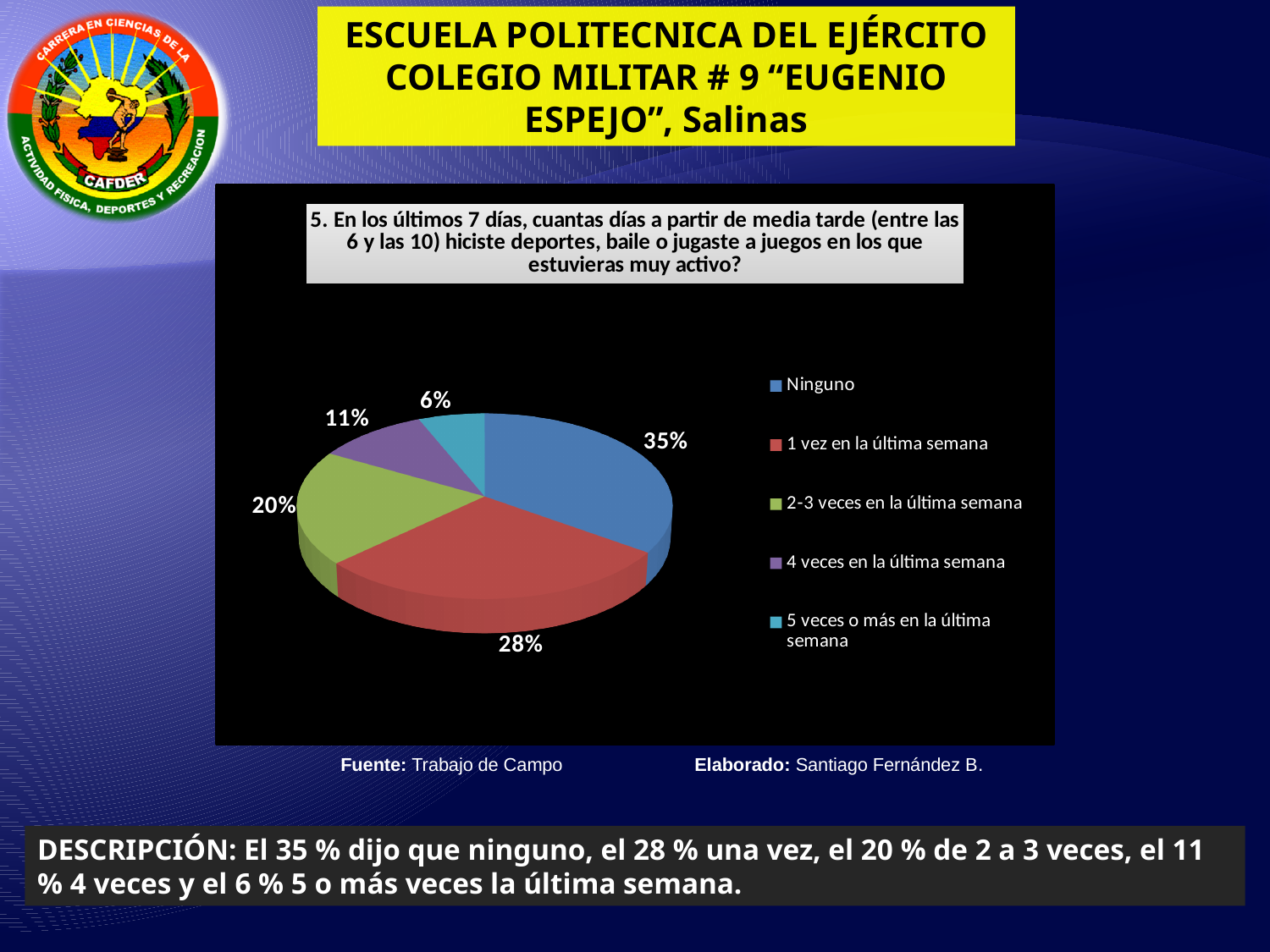
What percentage of respondents answered "4 veces en la última semana"? 11% What percentage of respondents answered "2-3 veces en la última semana"? 20% What percentage of respondents answered "1 vez en la última semana"? 28% Which is larger: the share for "2-3 veces en la última semana" or "4 veces en la última semana"? 2-3 veces en la última semana What colour is the slice for "Ninguno"? Blue How many categories does the legend list? 5 What percentage of respondents answered "Ninguno"? 35% What percentage of respondents answered "5 veces o más en la última semana"? 6% Which category has the largest share of the pie? Ninguno What kind of chart is shown on the slide? Pie chart Which category has the smallest share of the pie? 5 veces o más en la última semana What is the difference in percentage points between "Ninguno" and "1 vez en la última semana"? 7